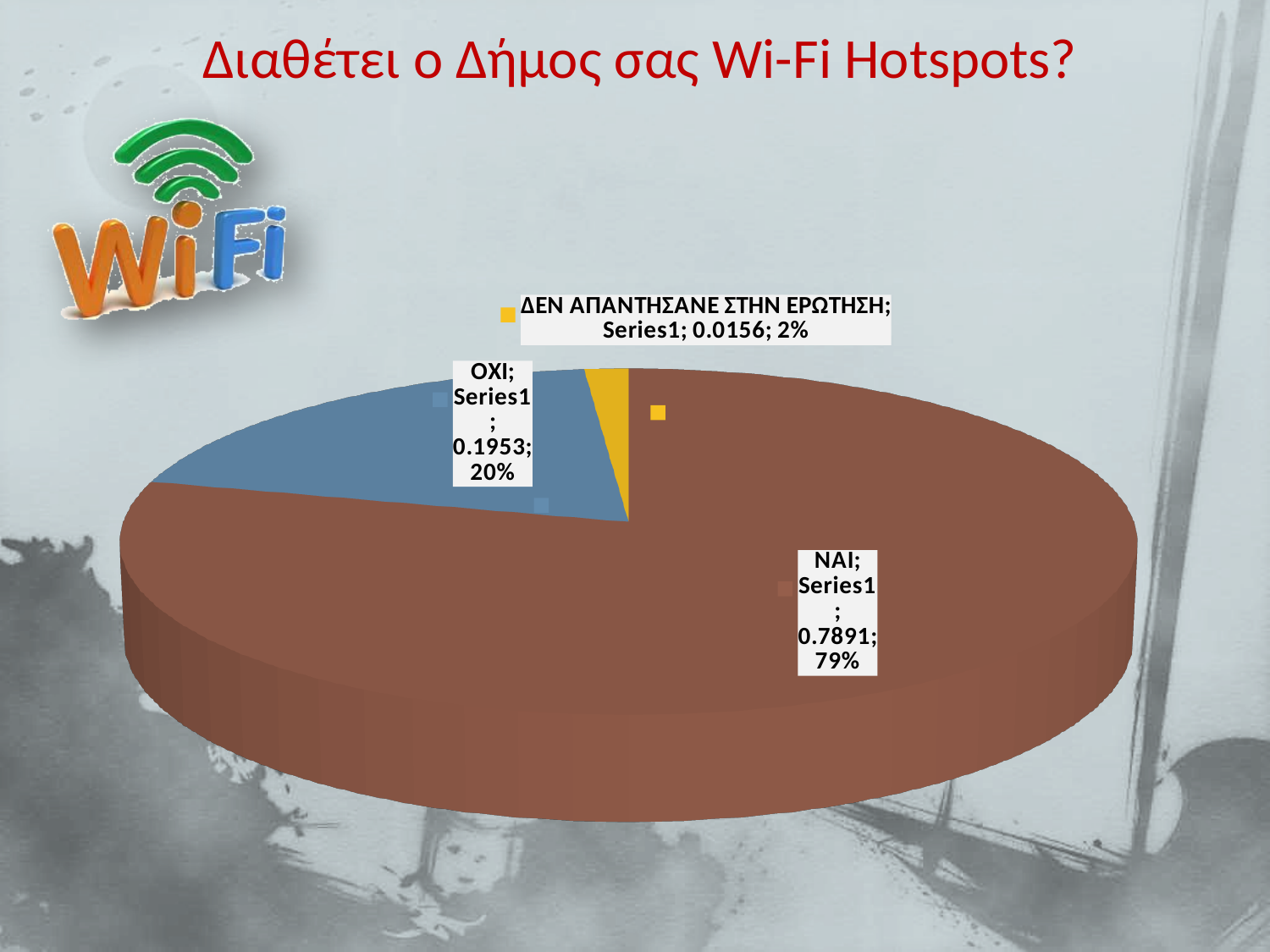
What kind of chart is shown on the slide? Pie chart What percentage share does the ΟΧΙ slice have? 20% How many slices does the pie chart have? 3 Which slice is the smallest? ΔΕΝ ΑΠΑΝΤΗΣΑΝΕ ΣΤΗΝ ΕΡΩΤΗΣΗ What value is printed for the ΝΑΙ slice? 0.7891 What percentage share does the ΔΕΝ ΑΠΑΝΤΗΣΑΝΕ ΣΤΗΝ ΕΡΩΤΗΣΗ slice have? 2% What percentage share does the ΝΑΙ slice have? 79% What value is printed for the ΔΕΝ ΑΠΑΝΤΗΣΑΝΕ ΣΤΗΝ ΕΡΩΤΗΣΗ slice? 0.0156 Which is larger, the ΟΧΙ slice or the ΔΕΝ ΑΠΑΝΤΗΣΑΝΕ ΣΤΗΝ ΕΡΩΤΗΣΗ slice? ΟΧΙ What value is printed for the ΟΧΙ slice? 0.1953 What is the title of the slide above the chart? Διαθέτει ο Δήμος σας Wi-Fi Hotspots? Which slice is the largest? ΝΑΙ